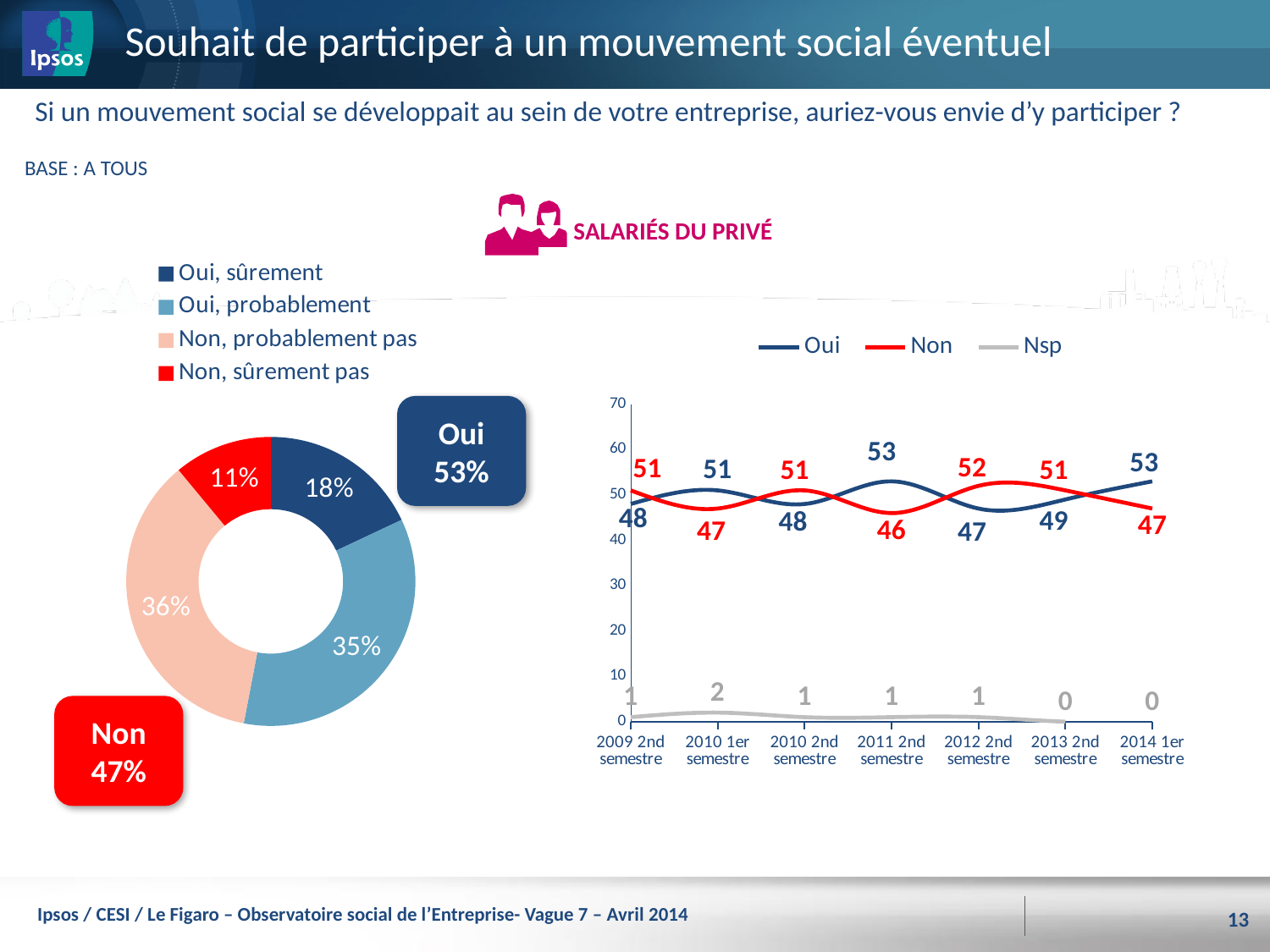
In the line chart on the right, which is larger in 2014 1er semestre, 'Oui' or 'Non'? Oui In the donut chart on the left, what is the difference between 'Non, probablement pas' and 'Oui, sûrement'? 18% In the line chart on the right, what is the value for 'Nsp' in 2010 1er semestre? 2 In the line chart on the right, how many time points are shown on the x axis? 7 In the line chart on the right, how many series does the legend list? 3 In the line chart on the right, what is the value for 'Non' in 2012 2nd semestre? 52 In the donut chart on the left, what share is 'Oui, probablement'? 35% In the donut chart on the left, which category has the largest share? Non, probablement pas In the line chart on the right, what is the value for 'Oui' in 2011 2nd semestre? 53 In the donut chart on the left, which category has the smallest share? Non, sûrement pas In the donut chart on the left, how many categories does the legend list? 4 In the donut chart on the left, what share is 'Non, sûrement pas'? 11%